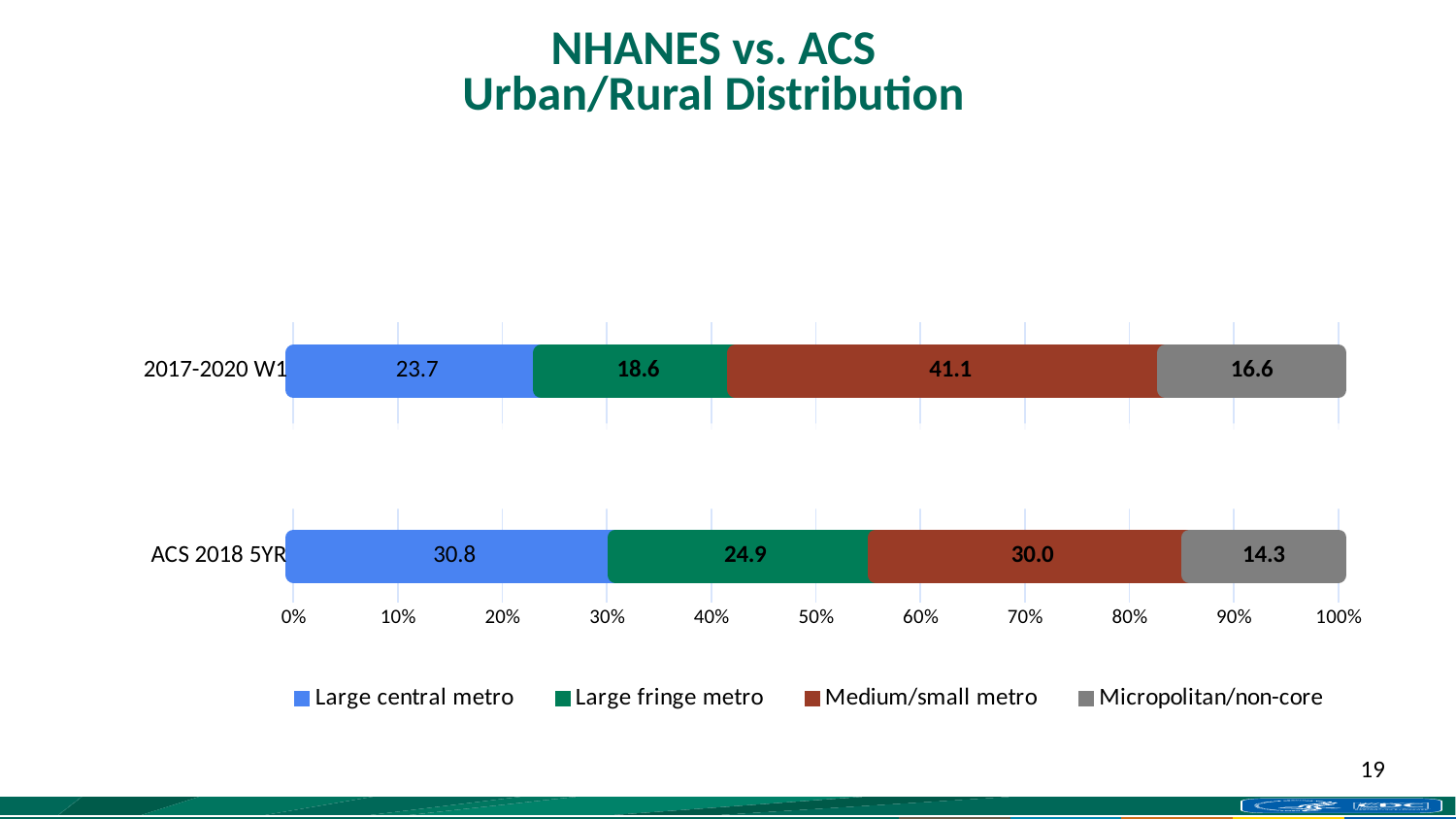
What kind of chart is shown on the slide? Stacked bar chart What is the value for Large central metro in the 2017-2020 W1 bar? 23.7 What is the value for Large fringe metro in the ACS 2018 5YR bar? 24.9 How many bars (categories) are shown in the chart? 2 How many series does the legend list? 4 Which series has the smallest segment in the ACS 2018 5YR bar? Micropolitan/non-core Which is larger: Large central metro for 2017-2020 W1 or for ACS 2018 5YR? ACS 2018 5YR What is the title of the chart? NHANES vs. ACS Urban/Rural Distribution What is the difference between the Medium/small metro values for 2017-2020 W1 and ACS 2018 5YR? 11.1 Which series has the largest segment in the 2017-2020 W1 bar? Medium/small metro What is the value for Medium/small metro in the ACS 2018 5YR bar? 30.0 What is the value for Micropolitan/non-core in the 2017-2020 W1 bar? 16.6